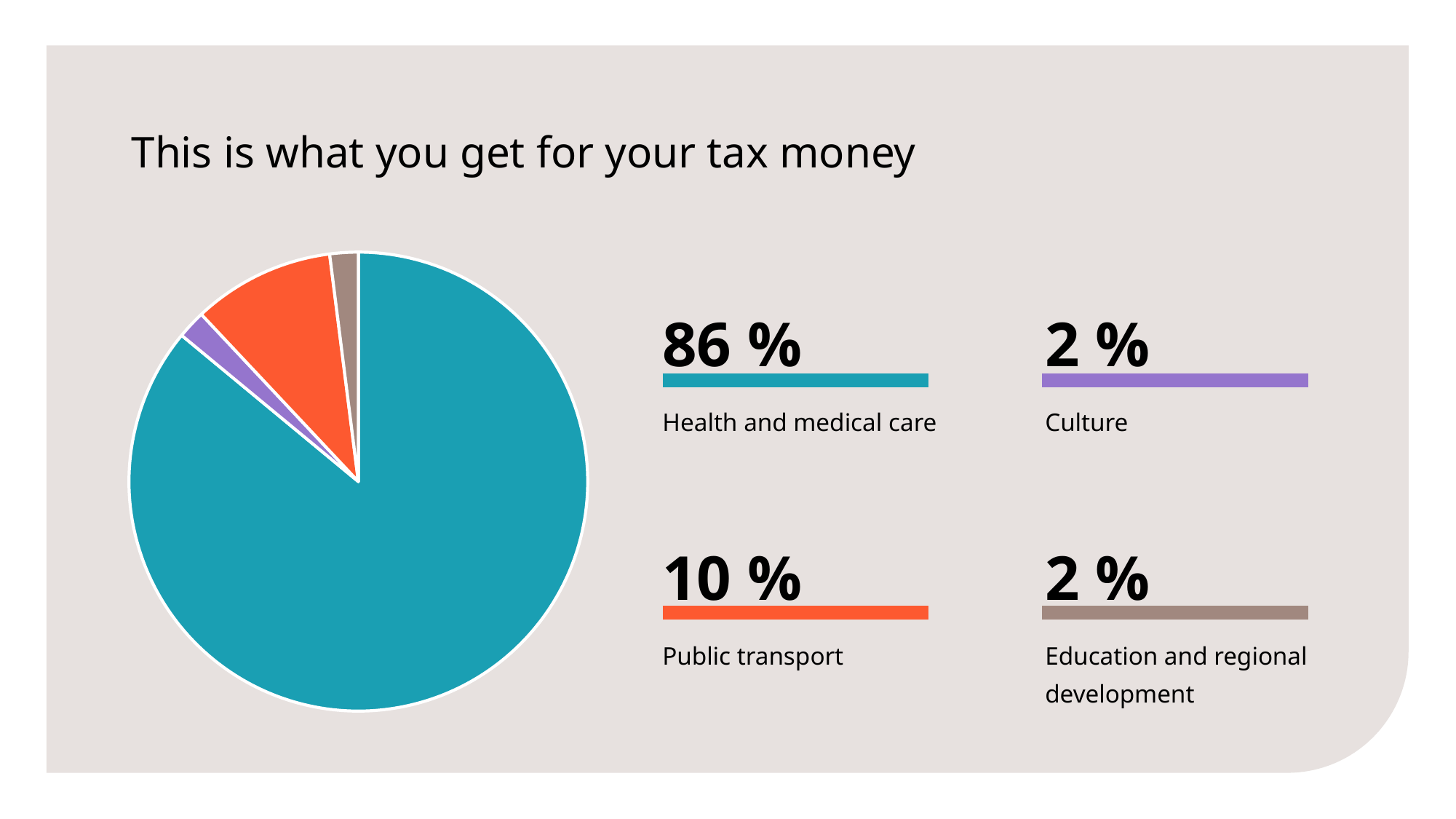
What share of tax money goes to Public transport? 10 % What is the difference in percentage points between Health and medical care and Public transport? 76 What share of tax money goes to Education and regional development? 2 % How many categories are shown in the pie chart? 4 Which is larger, the share for Public transport or the share for Culture? Public transport What is the title of the slide? This is what you get for your tax money What is the combined share of Culture and Education and regional development? 4 % Which category receives the largest share of tax money? Health and medical care What kind of chart is shown on the slide? Pie chart What share of tax money goes to Culture? 2 % What share of tax money goes to Health and medical care? 86 % What colour represents Public transport in the pie chart? Orange